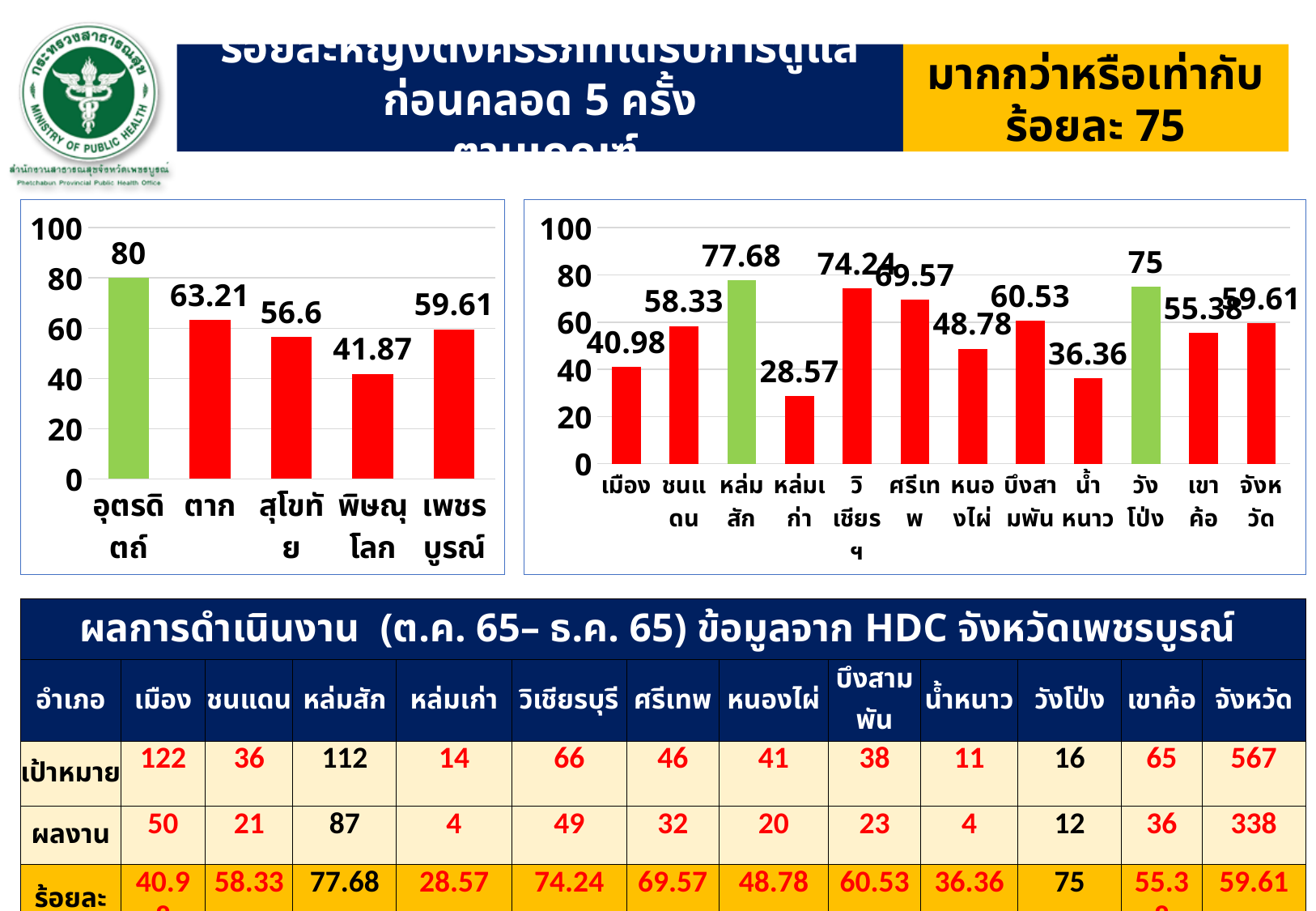
In the right chart, what is the difference between the values for วังโป่ง and น้ำหนาว? 38.64 In the right chart, which is larger, the value for วิเชียรบุรี or the value for ศรีเทพ? วิเชียรบุรี How many bars are shown in the right chart? 12 How many bars are shown in the left chart? 5 In the left chart, which category has the highest value? อุตรดิตถ์ In the left chart, what is the difference between the values for อุตรดิตถ์ and พิษณุโลก? 38.13 In the left chart, which category has the lowest value? พิษณุโลก In the right chart, what is the value for หล่มเก่า? 28.57 What type of chart is the right chart? Bar chart In the left chart, what is the value for ตาก? 63.21 In the right chart, which category has the lowest value? หล่มเก่า In the right chart, which category has the highest value? หล่มสัก